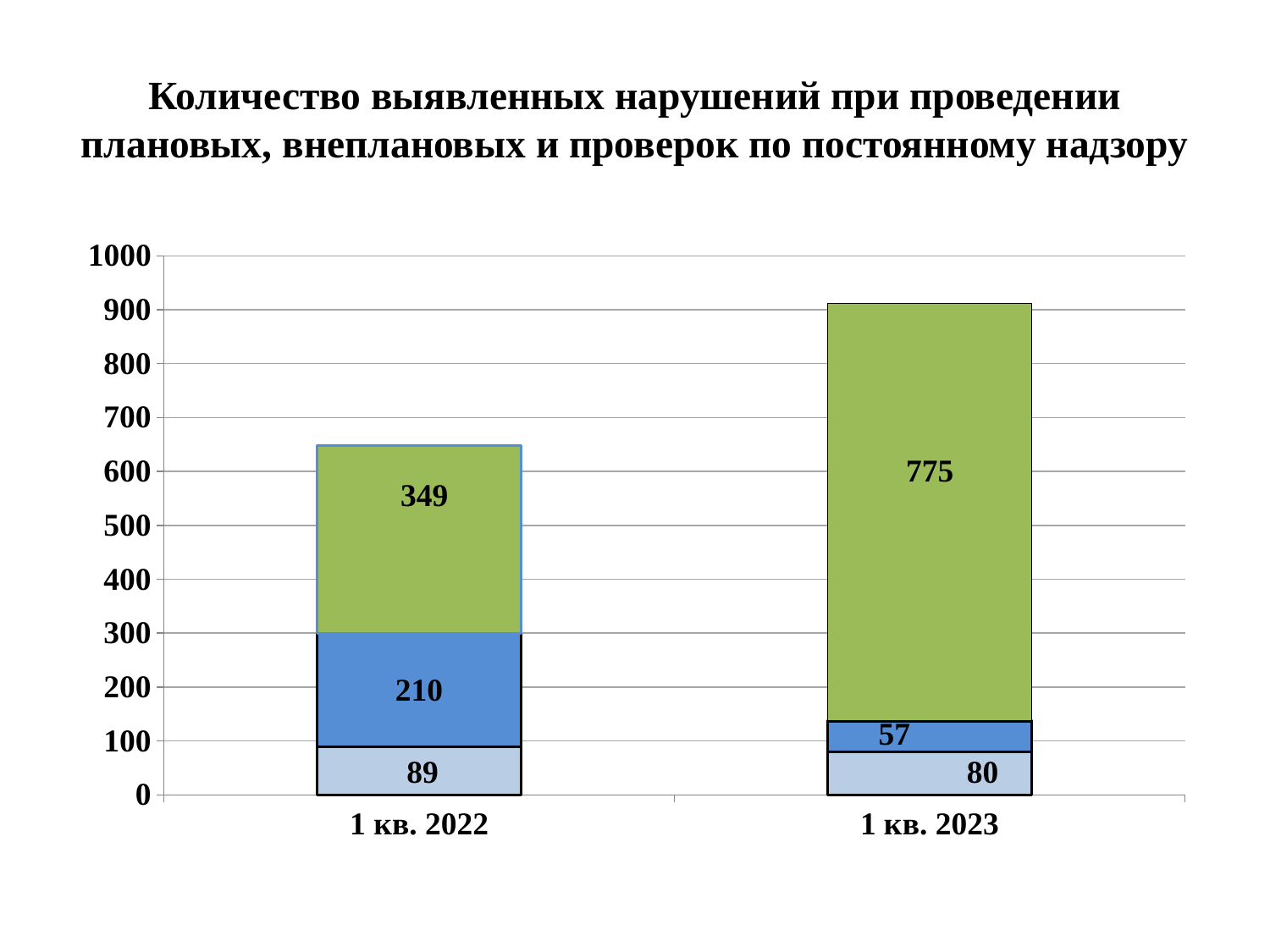
Which is larger: the dark blue (middle) segment for 1 кв. 2022 or for 1 кв. 2023? 1 кв. 2022 Is the total height of the bar for 1 кв. 2023 greater or less than 900? greater What kind of chart is shown on the slide? Stacked bar chart How many categories are shown on the x axis? 2 What is the total of the stacked bar for 1 кв. 2022? 648 What is the difference between the green segment values for 1 кв. 2023 and 1 кв. 2022? 426 What is the value of the light blue (bottom) segment for 1 кв. 2022? 89 What is the value of the green (top) segment for 1 кв. 2023? 775 What is the title of the chart? Количество выявленных нарушений при проведении плановых, внеплановых и проверок по постоянному надзору What is the value of the green (top) segment for 1 кв. 2022? 349 What is the value of the dark blue (middle) segment for 1 кв. 2023? 57 What is the total of the stacked bar for 1 кв. 2023? 912